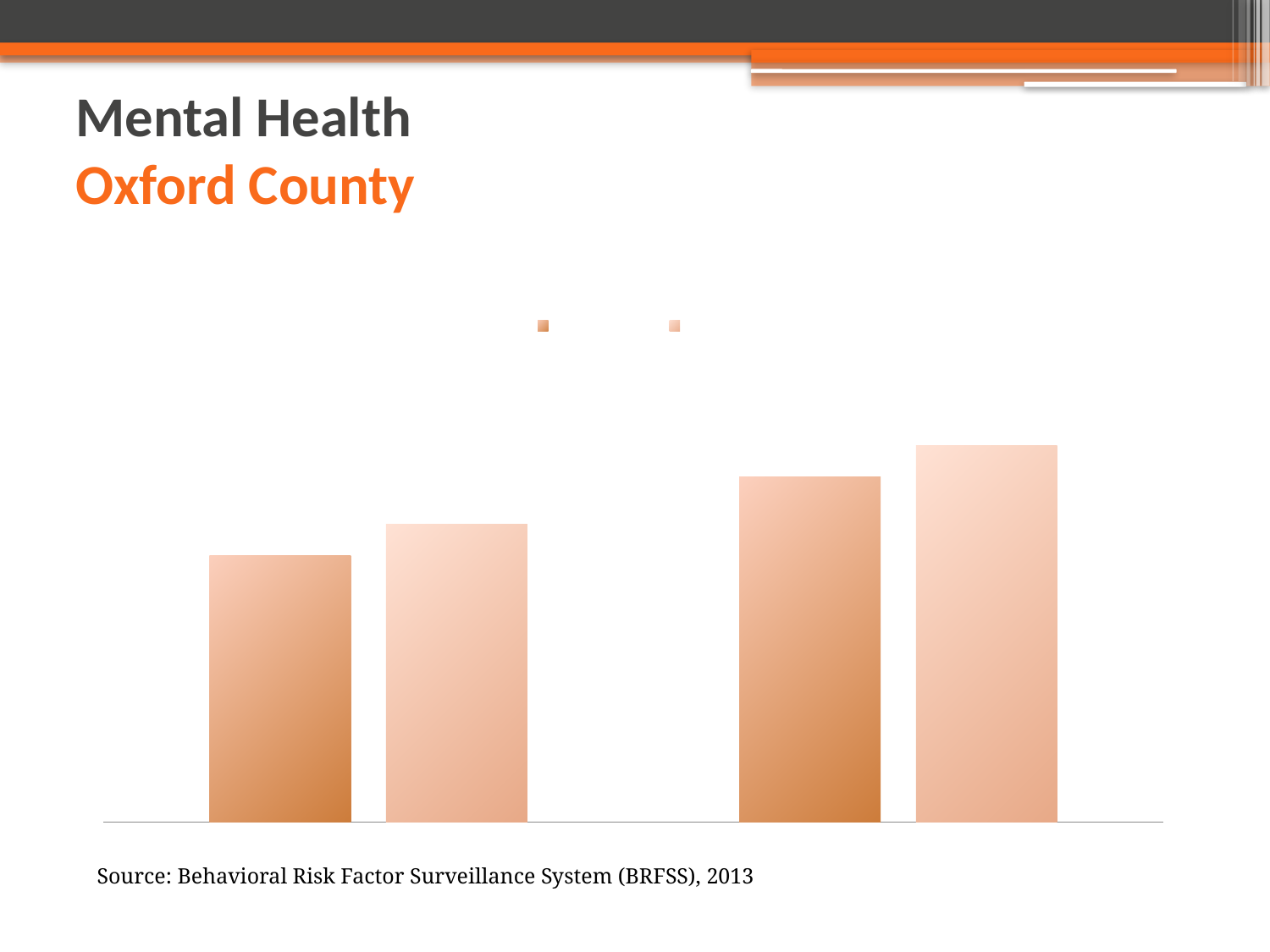
How many series does the chart's legend show? 2 Is the rightmost bar taller or shorter than the third bar from the left? taller Which county is named in the slide title? Oxford County Is the leftmost bar taller or shorter than the second bar from the left? shorter How many groups of bars are there in the chart? 2 What kind of chart is shown on the slide? bar chart Is the right-hand group of bars taller or shorter than the left-hand group? taller Which bar is the shortest in the chart, by position? the leftmost bar What data source is cited below the chart? Behavioral Risk Factor Surveillance System (BRFSS), 2013 How many bars are plotted in the chart? 4 Which bar is the tallest in the chart, by position? the rightmost bar